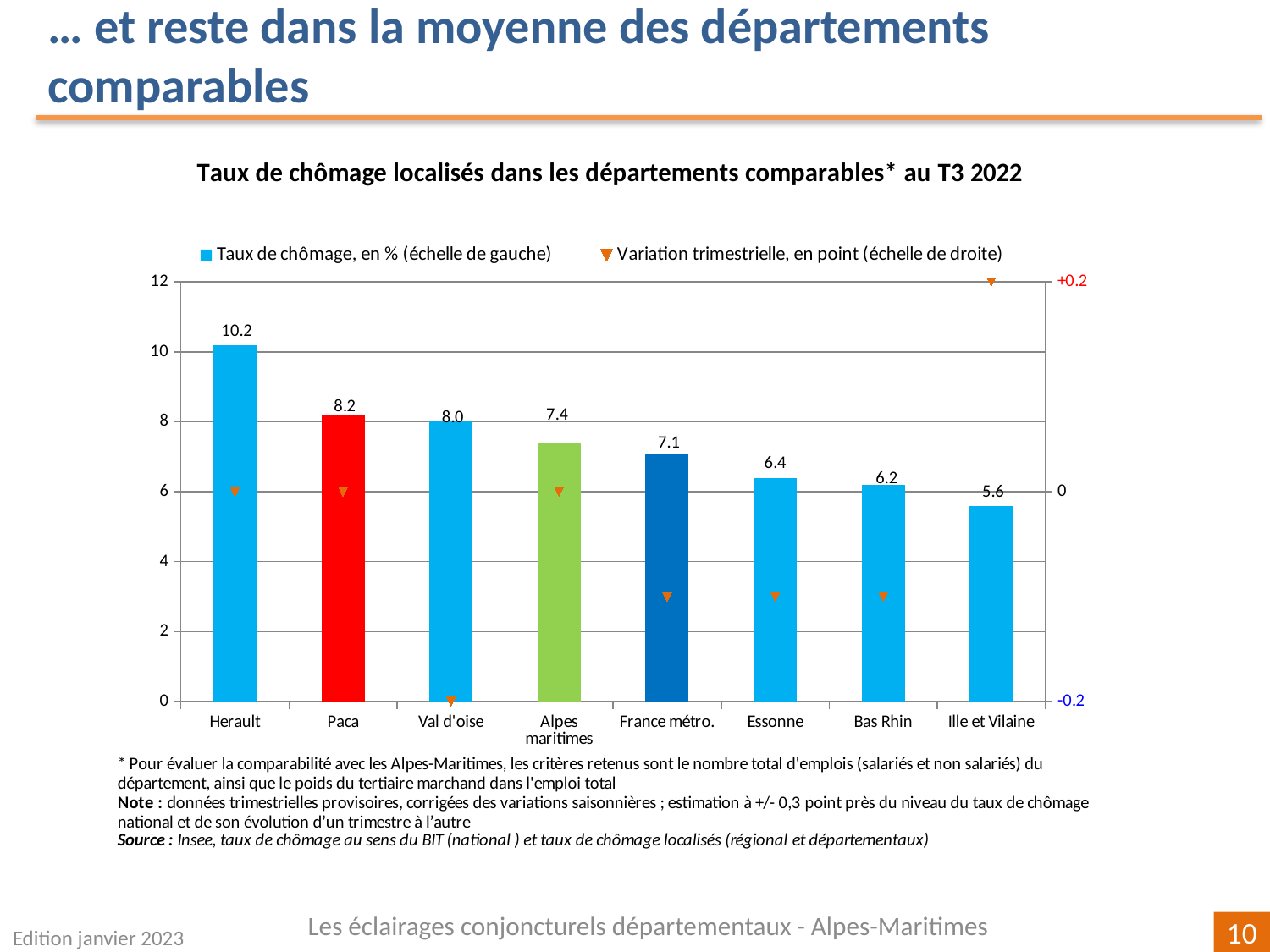
How many categories are shown on the x axis? 8 Which category has the highest unemployment rate bar? Herault What is the quarterly variation (Variation trimestrielle) marker value for Ille et Vilaine on the right axis? +0.2 What is the unemployment rate shown for Alpes maritimes? 7.4 What kind of chart is used for the unemployment rate series? Bar chart How many series does the legend list? 2 What is the unemployment rate shown for France métro.? 7.1 Which category has the lowest unemployment rate bar? Ille et Vilaine Is the quarterly variation for France métro. greater or less than 0? less What is the difference between the unemployment rates of Paca and Essonne? 1.8 What is the unemployment rate (Taux de chômage) shown for Herault? 10.2 Which has a higher unemployment rate, Val d'oise or Bas Rhin? Val d'oise